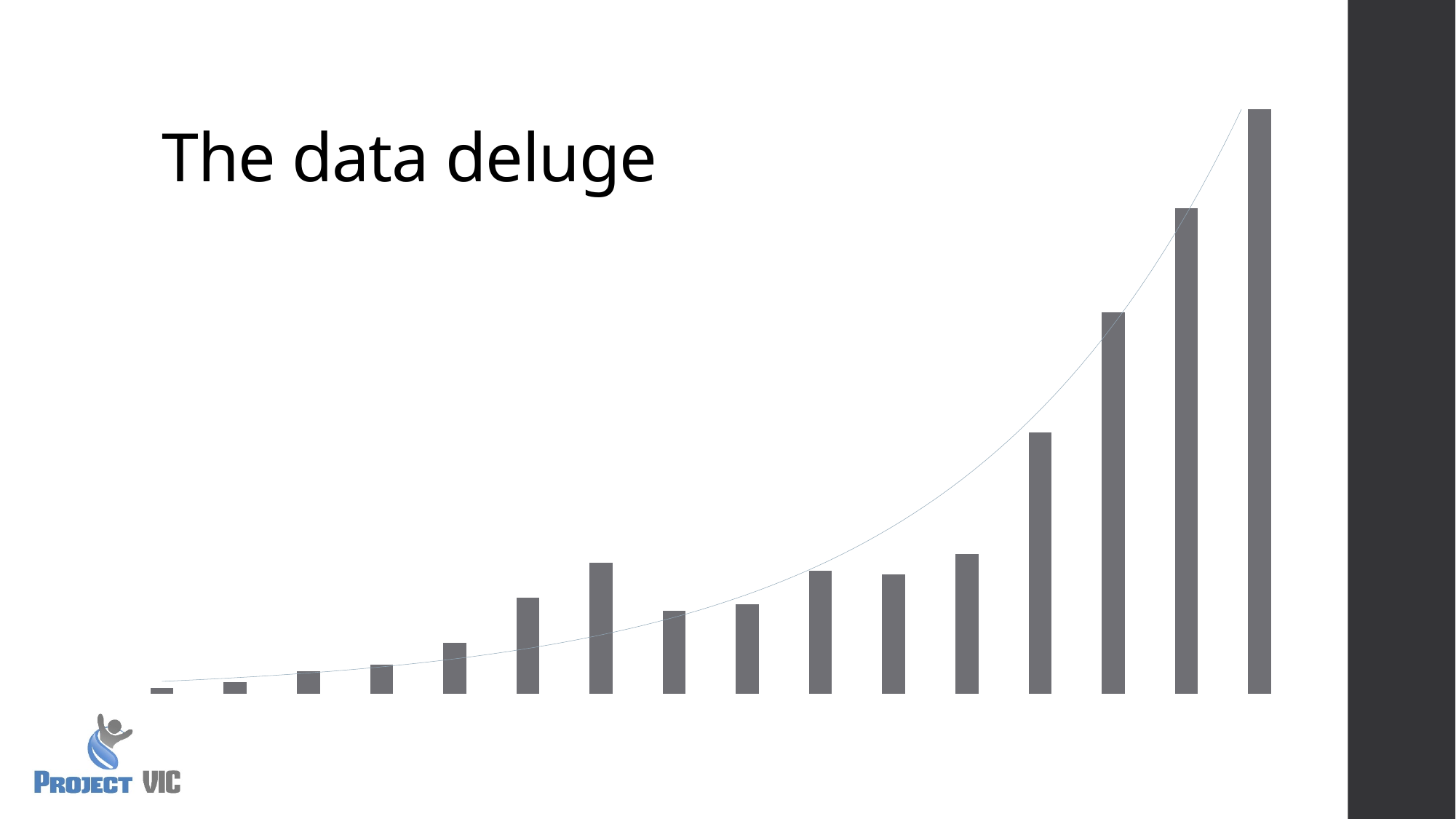
Which bar is the shortest in the chart? the leftmost bar How many bars does the chart contain? 16 What kind of chart is shown on the slide? bar chart Which is taller, the second-to-last bar or the last bar on the right? the last bar Which is taller, the seventh bar from the left or the eighth bar from the left? the seventh bar Do the bar values generally rise or fall from left to right across the chart? rise Besides the bars, what other element is overlaid on the chart? a curved trend line Which is taller, the leftmost bar or the rightmost bar? the rightmost bar What is the title shown above the chart on the slide? The data deluge Which bar is the tallest in the chart? the rightmost bar